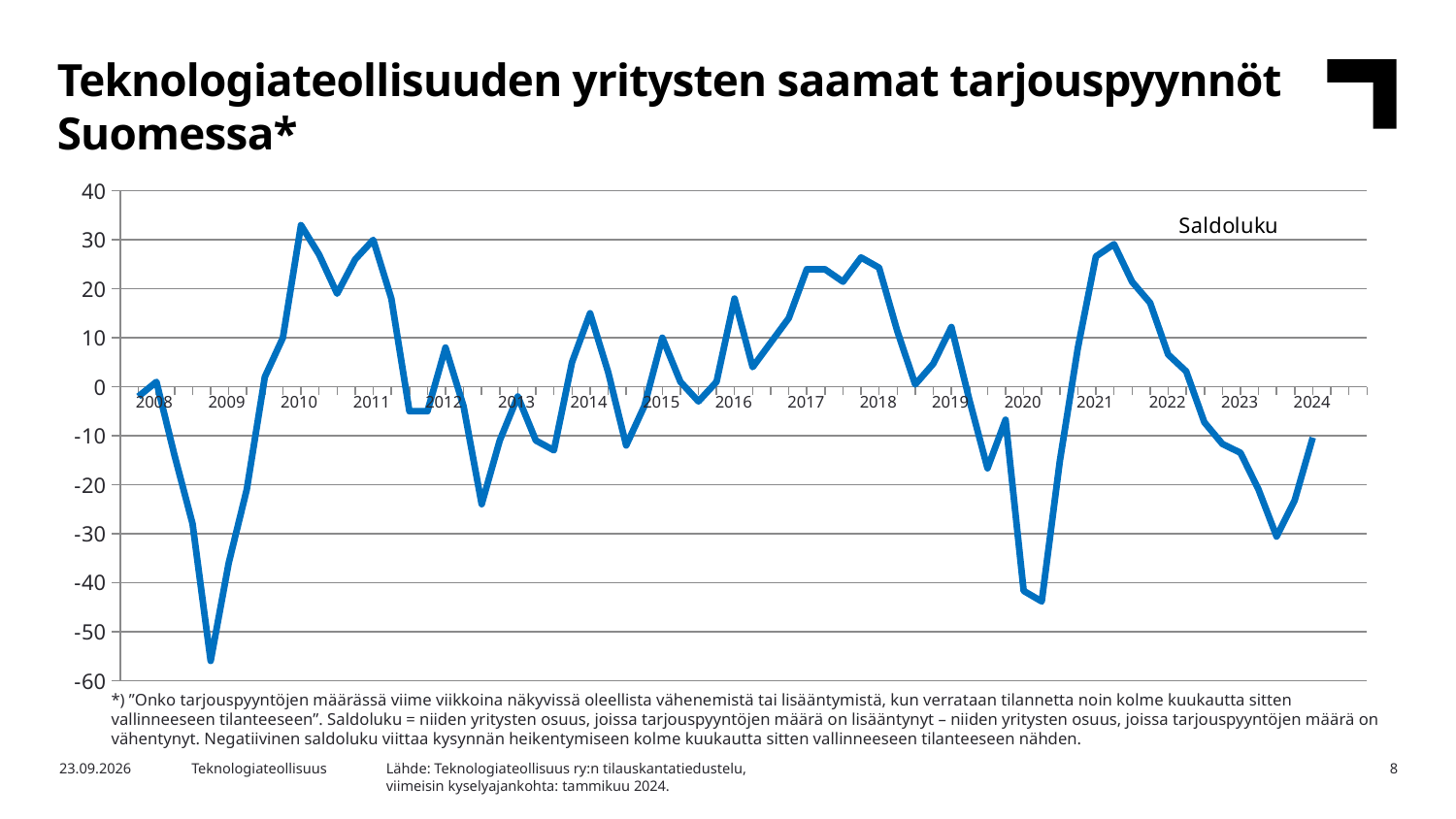
Is the last plotted value of the line in 2024 greater or less than 0? less What is the name of the series shown in the chart legend? Saldoluku What kind of chart is shown on the slide? line chart In which year does the line reach its lowest point? 2009 Does the line rise or fall between its 2021 peak and 2023? fall What is the title of the chart on the slide? Teknologiateollisuuden yritysten saamat tarjouspyynnöt Suomessa* Is the peak value of the line in 2021 greater or less than 20? greater Is the peak value of the line in 2010 greater or less than 30? greater Which is larger: the lowest value of the line in 2009 or the lowest value in 2020? 2020 How many series does the chart legend list? 1